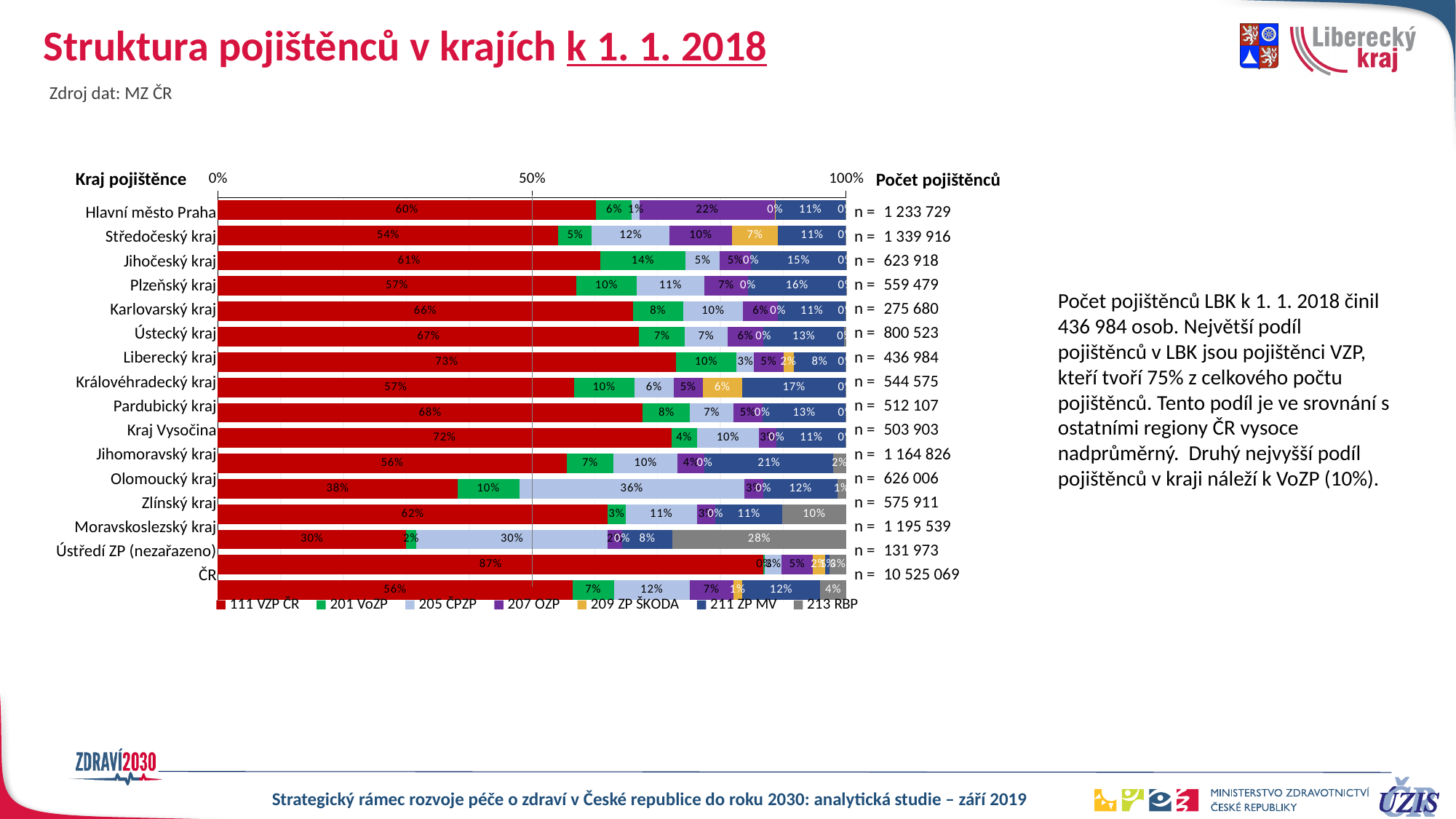
How many rows (regions including Ústředí ZP and ČR) are plotted in the chart? 16 Which has a larger share of 111 VZP ČR, Pardubický kraj or Kraj Vysočina? Kraj Vysočina Which row has the highest share of 111 VZP ČR? Ústředí ZP (nezařazeno) What is the difference in percentage points between the 111 VZP ČR share of Hlavní město Praha and Středočeský kraj? 6 percentage points What kind of chart is shown on the slide? stacked bar chart What is the share of 111 VZP ČR for Hlavní město Praha? 60% What is the share of 205 ČPZP for Olomoucký kraj? 36% Which row has the lowest share of 111 VZP ČR? Moravskoslezský kraj What is the share of 207 OZP for Hlavní město Praha? 22% How many series does the legend list? 7 What is the share of 213 RBP for Moravskoslezský kraj? 28% What is the number of insured persons (Počet pojištěnců) shown for Liberecký kraj? 436 984